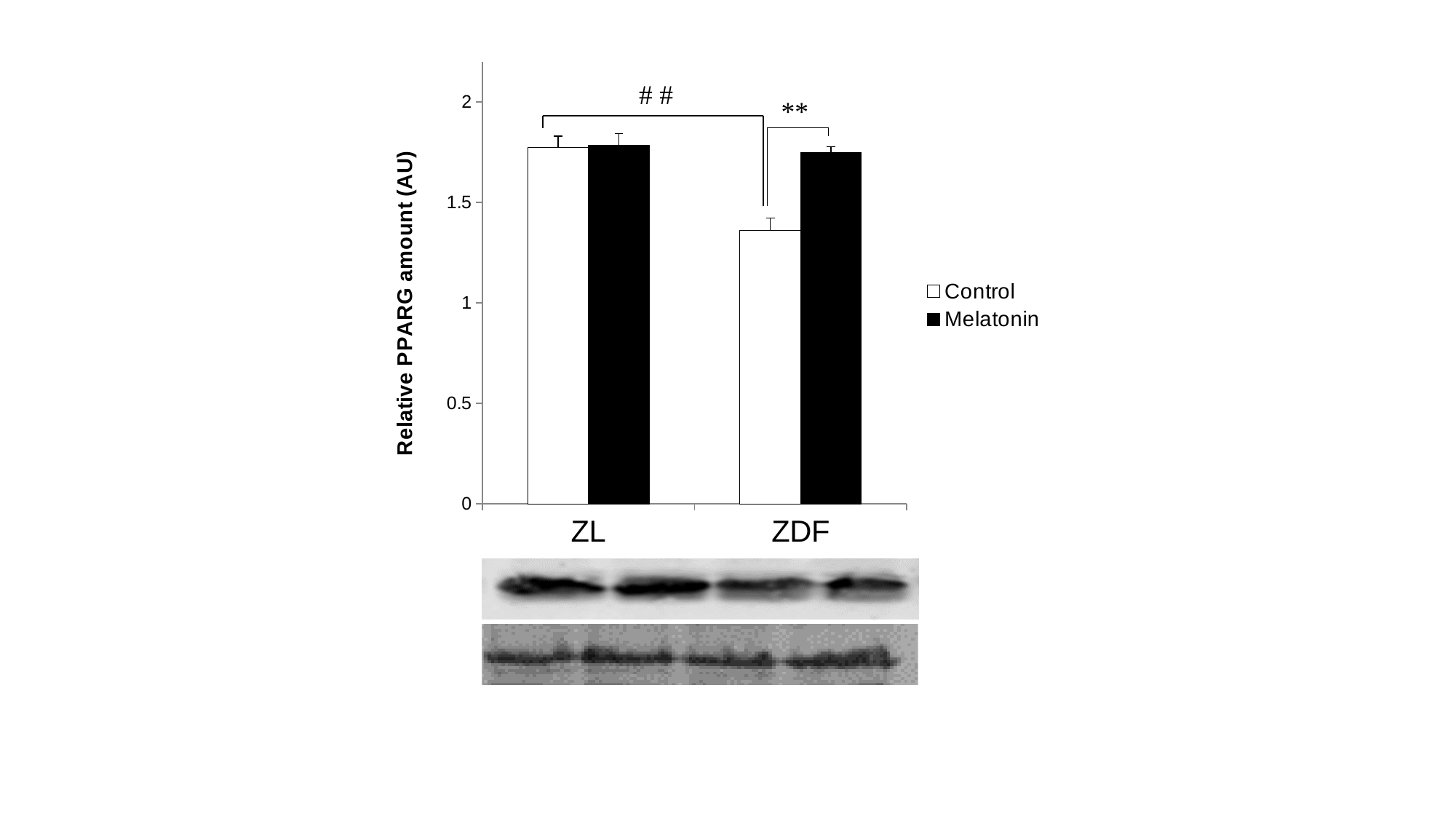
Is the Control value for ZL greater or less than 1.5? greater What are the two series named in the legend? Control and Melatonin What kind of chart is shown on the slide? bar chart Is the Melatonin value for ZL greater or less than 2? less How many series does the chart's legend list? 2 Is the Melatonin value for ZDF greater or less than 1.5? greater Which bar has the lowest value in the chart? ZDF Control How many categories are shown on the x axis of the chart? 2 Which is larger: the Control value for ZL or the Control value for ZDF? ZL What is the label of the y axis? Relative PPARG amount (AU) For ZDF, which is larger: the Control value or the Melatonin value? Melatonin